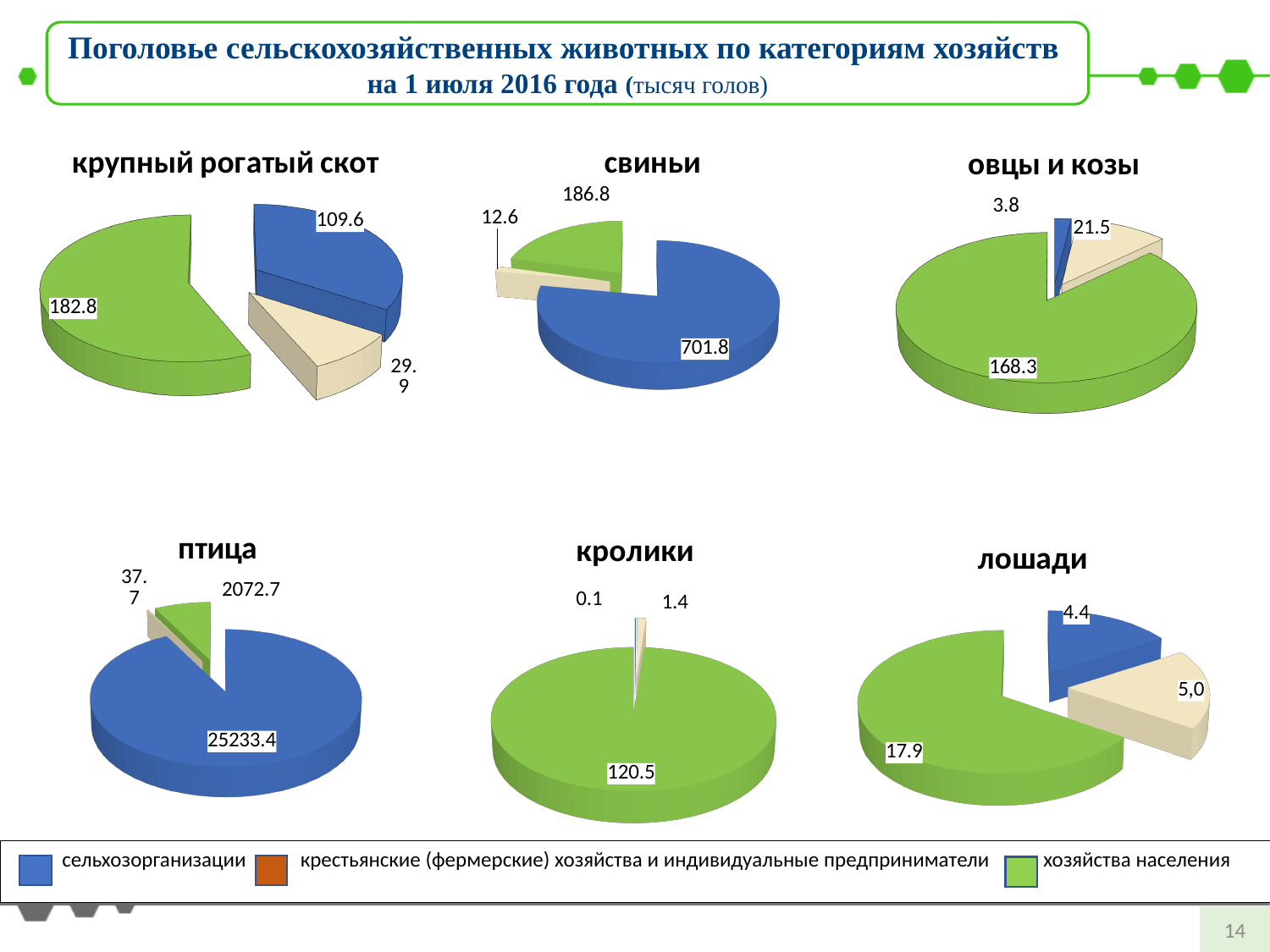
What type of chart is used for 'птица'? pie chart In the 'лошади' chart, what is the value for сельхозорганизации (blue slice)? 4.4 How many pie charts are shown on the slide? 6 In the 'кролики' chart, what is the value for хозяйства населения (green slice)? 120.5 In the 'крупный рогатый скот' chart, what is the value for хозяйства населения (green slice)? 182.8 How many slices does the 'овцы и козы' chart have? 3 In the 'свиньи' chart, what is the difference between the сельхозорганизации value (701.8) and the хозяйства населения value (186.8)? 515.0 What is the total of all slices in the 'лошади' chart? 27.3 In the 'свиньи' chart, what is the value for сельхозорганизации (blue slice)? 701.8 In the 'крупный рогатый скот' chart, which is larger: the сельхозорганизации slice or the хозяйства населения slice? хозяйства населения In the 'овцы и козы' chart, what is the value of the smallest slice? 3.8 In the 'птица' chart, which category has the largest slice? сельхозорганизации